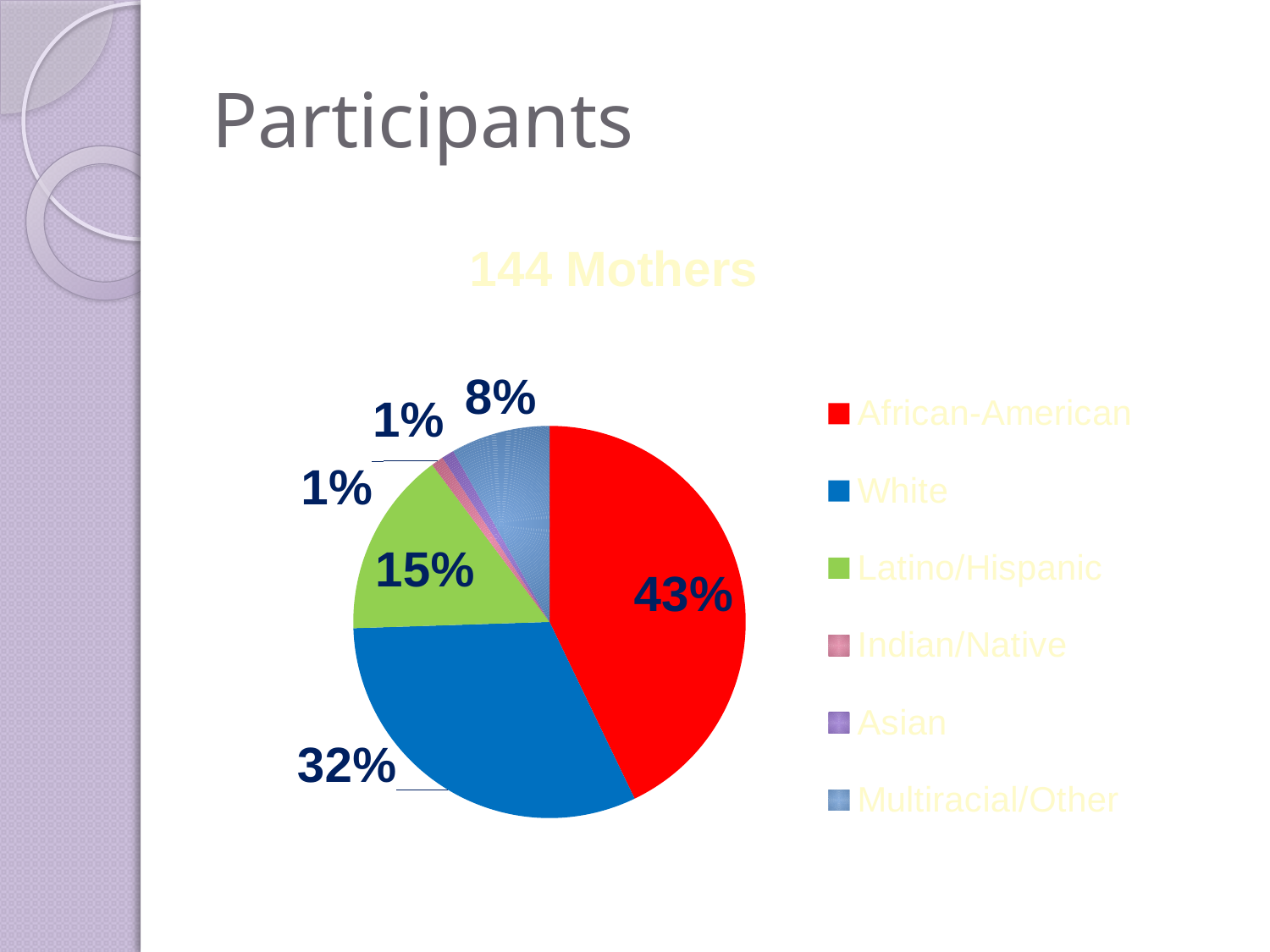
What is the title of the pie chart? 144 Mothers Which slice is larger, Latino/Hispanic or Multiracial/Other? Latino/Hispanic What percentage of participants are Asian? 1% Which group makes up the largest share of the pie chart? African-American What percentage of participants are White? 32% What is the difference in percentage points between the African-American and White slices? 11 What percentage of participants are Multiracial/Other? 8% What type of chart is shown on the slide? pie chart What colour is the slice representing White participants? blue What percentage of participants are Latino/Hispanic? 15% What percentage of participants are African-American? 43% How many categories does the legend of the pie chart list? 6